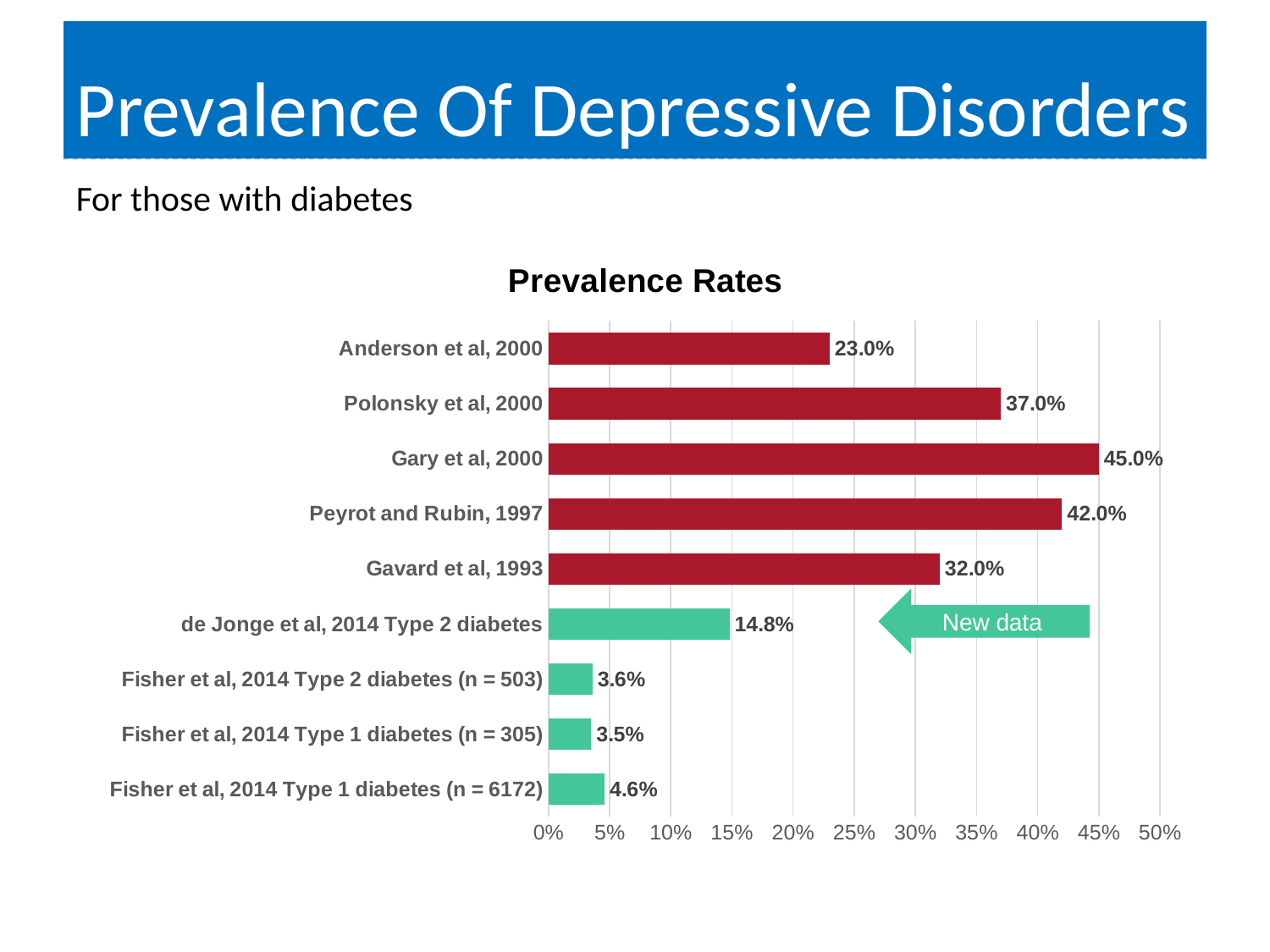
What is the prevalence rate for Anderson et al, 2000? 23.0% What does the arrow label pointing at the green bars say? New data What is the difference between the prevalence rates of Gary et al, 2000 and Gavard et al, 1993? 13.0% Which study has the lowest prevalence rate? Fisher et al, 2014 Type 1 diabetes (n = 305) What type of chart is shown on the slide? bar chart What is the title of the chart? Prevalence Rates Which study has the highest prevalence rate? Gary et al, 2000 Is the prevalence rate for Gavard et al, 1993 greater or less than 30%? greater What is the prevalence rate for de Jonge et al, 2014 Type 2 diabetes? 14.8% What is the prevalence rate for Fisher et al, 2014 Type 1 diabetes (n = 6172)? 4.6% Which has a higher prevalence rate, Polonsky et al, 2000 or Peyrot and Rubin, 1997? Peyrot and Rubin, 1997 How many studies are shown in the chart? 9